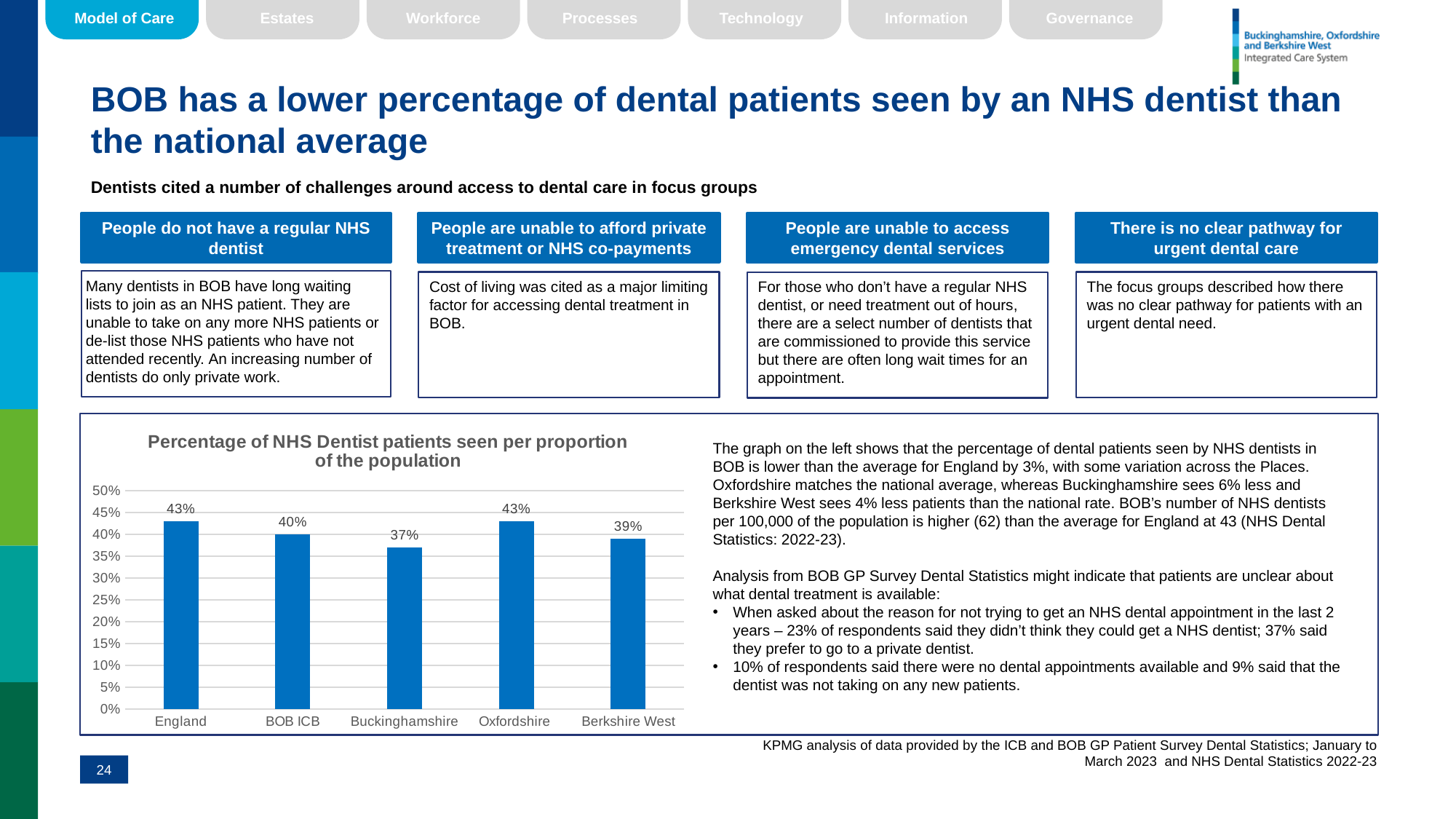
What kind of chart is shown on the slide? bar chart What is the value for BOB ICB in the chart? 40% What is the difference between the values for Oxfordshire and Buckinghamshire? 6% What is the difference between the values for England and BOB ICB? 3% How many categories are shown on the x axis of the chart? 5 What is the value for Buckinghamshire in the chart? 37% Which is larger, the value for BOB ICB or the value for Berkshire West? BOB ICB Which category has the lowest value in the chart? Buckinghamshire Is the value for Buckinghamshire greater or less than 40%? less What is the title of the chart? Percentage of NHS Dentist patients seen per proportion of the population What is the value for England in the chart? 43% What is the value for Berkshire West in the chart? 39%